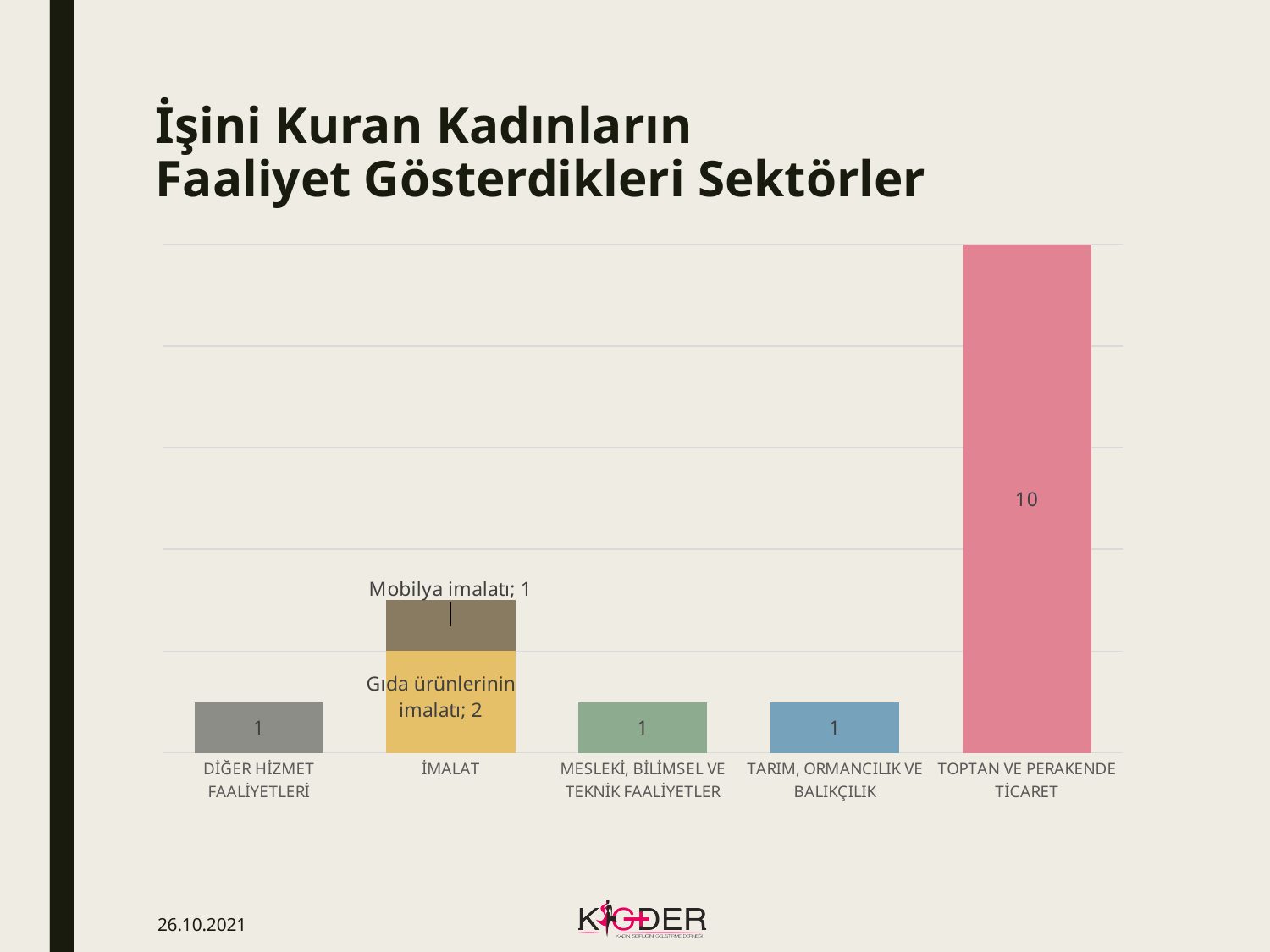
What is the total of the stacked İMALAT bar? 3 What is the difference between the value for TOPTAN VE PERAKENDE TİCARET and the value for MESLEKİ, BİLİMSEL VE TEKNİK FAALİYETLER? 9 What is the value for TOPTAN VE PERAKENDE TİCARET? 10 What is the title of the slide containing the chart? İşini Kuran Kadınların Faaliyet Gösterdikleri Sektörler What is the value for DİĞER HİZMET FAALİYETLERİ? 1 Which is larger, the value for TOPTAN VE PERAKENDE TİCARET or the total of the İMALAT bar? TOPTAN VE PERAKENDE TİCARET What kind of chart is shown on the slide? Bar chart How many categories are shown on the x axis? 5 Which category has the highest value? TOPTAN VE PERAKENDE TİCARET What is the value of the Gıda ürünlerinin imalatı segment in the İMALAT bar? 2 What is the value for TARIM, ORMANCILIK VE BALIKÇILIK? 1 What is the value of the Mobilya imalatı segment in the İMALAT bar? 1